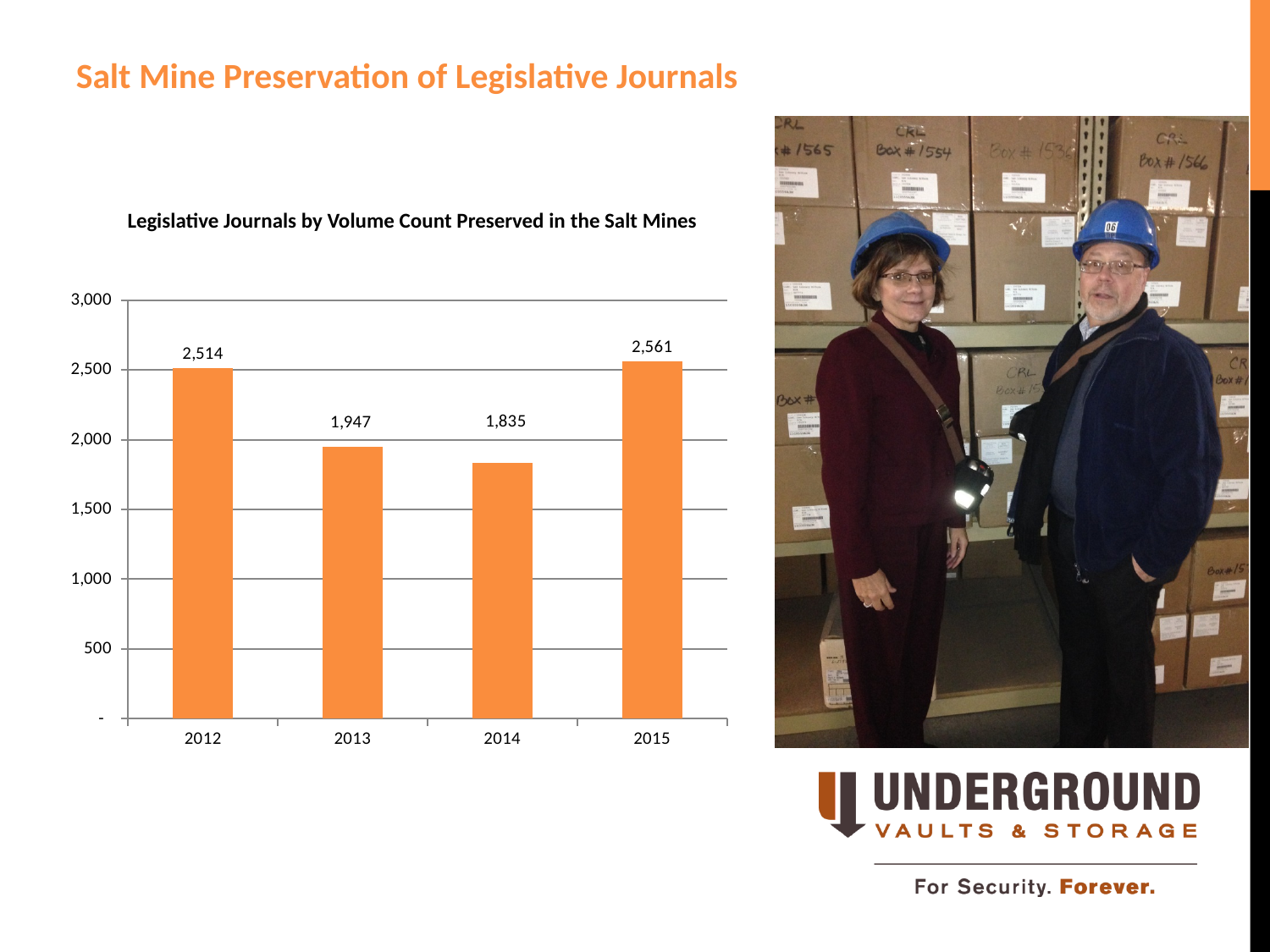
Which year has the highest volume count? 2015 What kind of chart is shown on the slide? bar chart What is the value for 2013? 1,947 What is the difference between the values for 2012 and 2013? 567 Which year has the lowest volume count? 2014 How many years are shown on the x axis? 4 What is the value for 2012? 2,514 Which is larger, the value for 2013 or the value for 2014? 2013 What is the value for 2015? 2,561 What is the difference between the values for 2015 and 2014? 726 What is the value for 2014? 1,835 Is the value for 2013 greater or less than 2,000? less